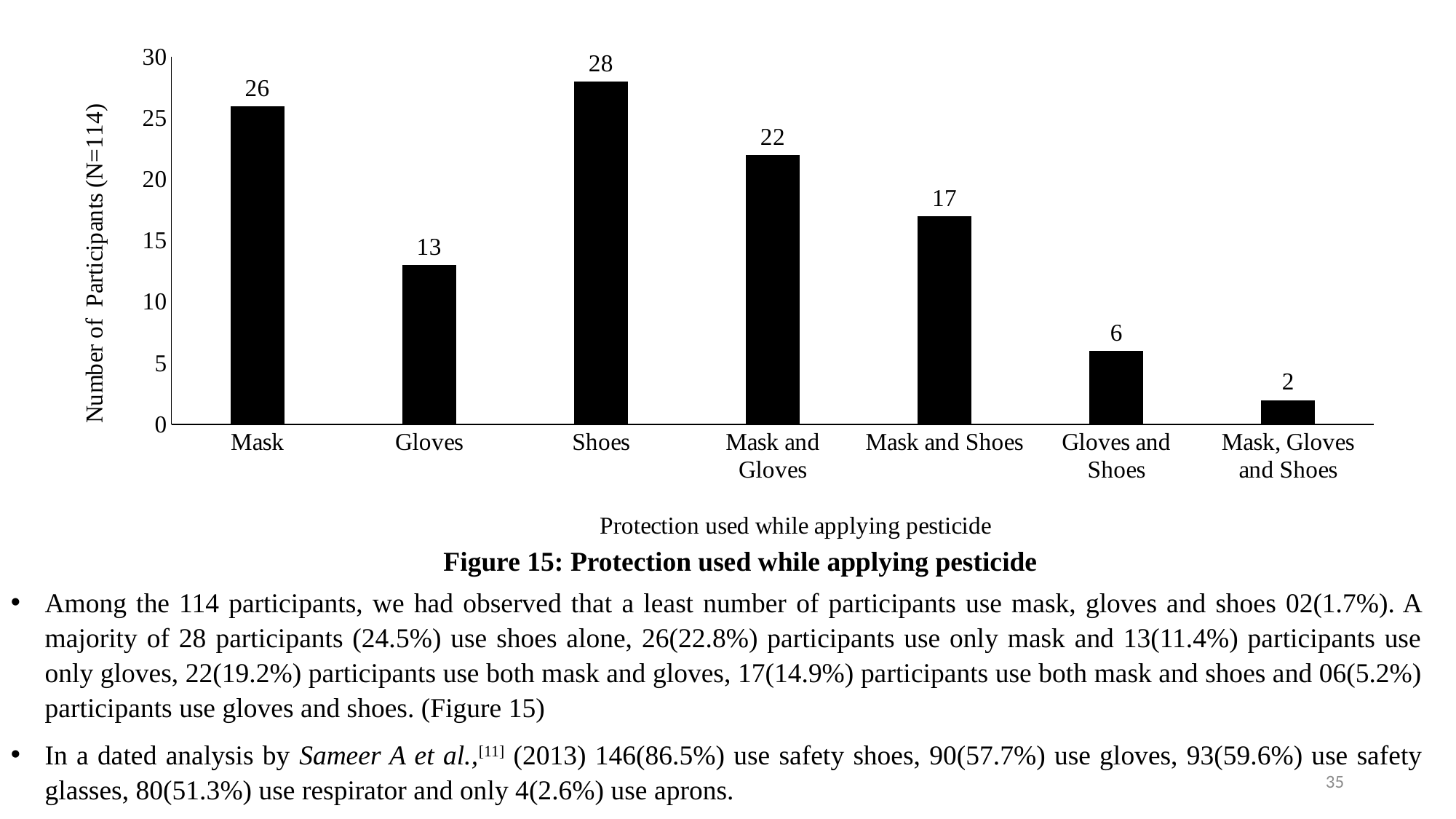
Which protection category has the highest number of participants? Shoes What kind of chart is shown on the slide? Bar chart Which has more participants: Mask and Shoes or Mask and Gloves? Mask and Gloves How many protection categories are shown on the x axis? 7 Is the value for Mask greater or less than 25? greater What is the figure caption of the chart? Figure 15: Protection used while applying pesticide What is the number of participants who use gloves and shoes? 6 How many participants use mask and gloves? 22 How many participants use only a mask while applying pesticide? 26 Which protection category has the lowest number of participants? Mask, Gloves and Shoes What is the difference between the number of participants using shoes and those using gloves? 15 What is the title of the y axis of the chart? Number of Participants (N=114)